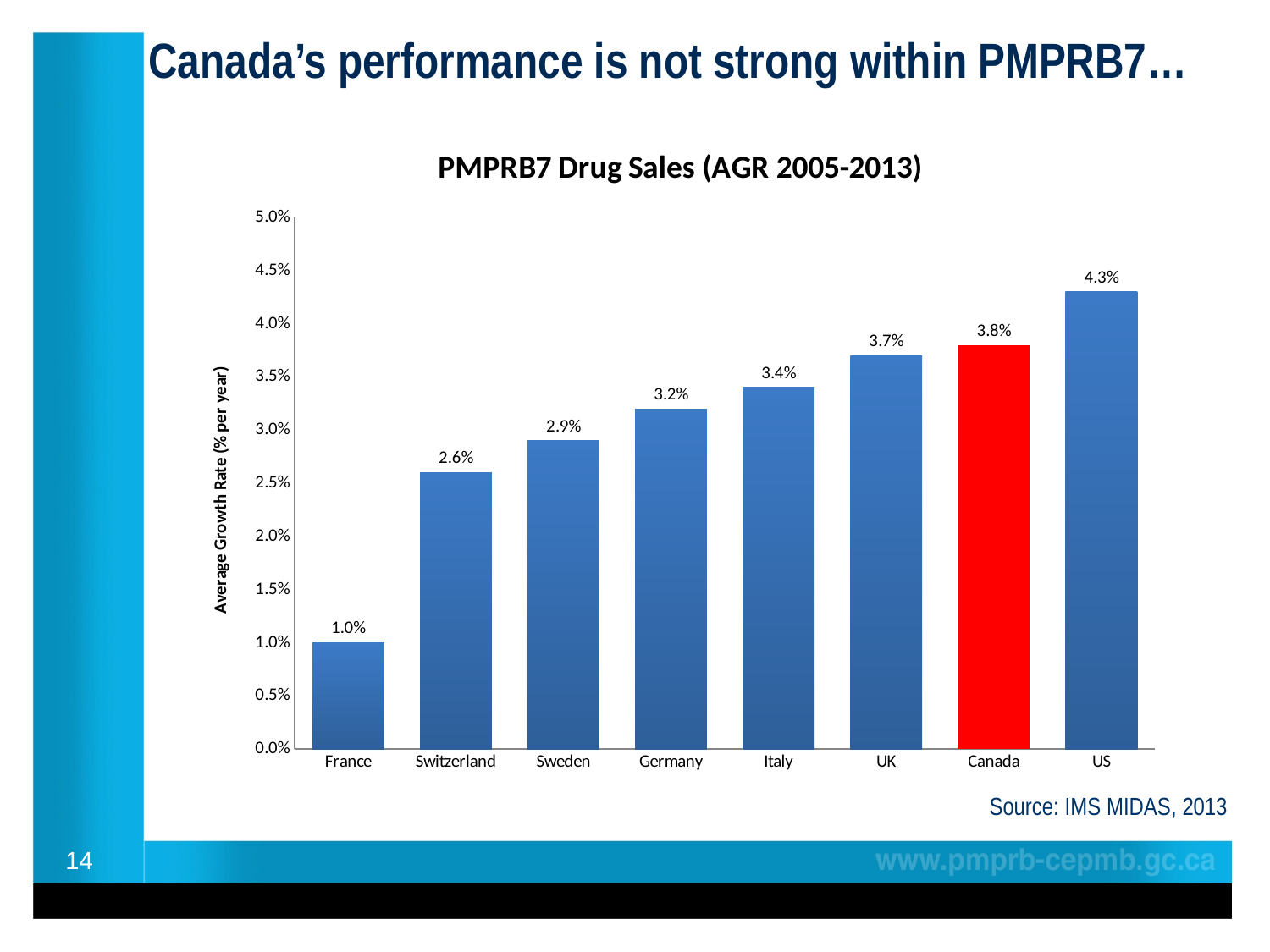
What kind of chart is shown on the slide? Bar chart What is the difference between the growth rates of Switzerland and France? 1.6% What is the difference between the growth rates of the US and Canada? 0.5% Which country's bar is highlighted in red? Canada What is the average growth rate for France? 1.0% What is the average growth rate for Germany? 3.2% Which has a higher average growth rate, Italy or Sweden? Italy Is the value for UK greater or less than 3.0%? greater Which country has the highest average growth rate? US How many countries are shown in the chart? 8 What is the average growth rate for Canada? 3.8% Which country has the lowest average growth rate? France